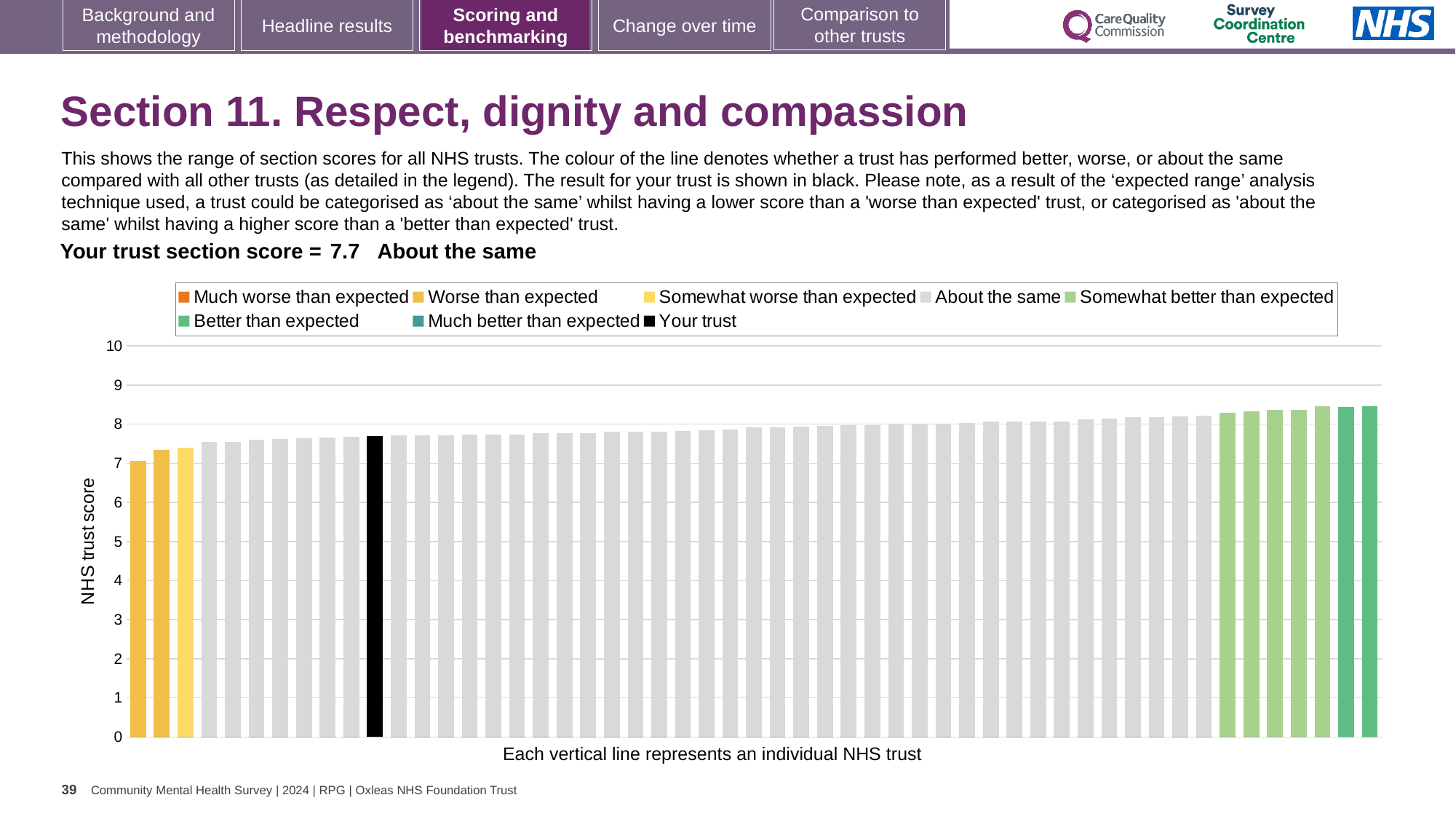
Is the value for the leftmost bar greater or less than 8? less Is the value for the rightmost bar greater or less than 8? greater Is the value for your trust (the black bar) greater or less than 7? greater What is the highest value shown on the y axis? 10 How many bars are coloured green (somewhat better or better than expected)? 7 What colour is the bar representing your trust? black How many bars are coloured yellow (worse or somewhat worse than expected)? 3 What kind of chart is shown on the slide? bar chart Do the bar values rise or fall from left to right along the x axis? rise What is the section score for your trust shown on the slide? 7.7 How many entries does the chart legend list? 8 Which category is your trust's section score placed in? About the same